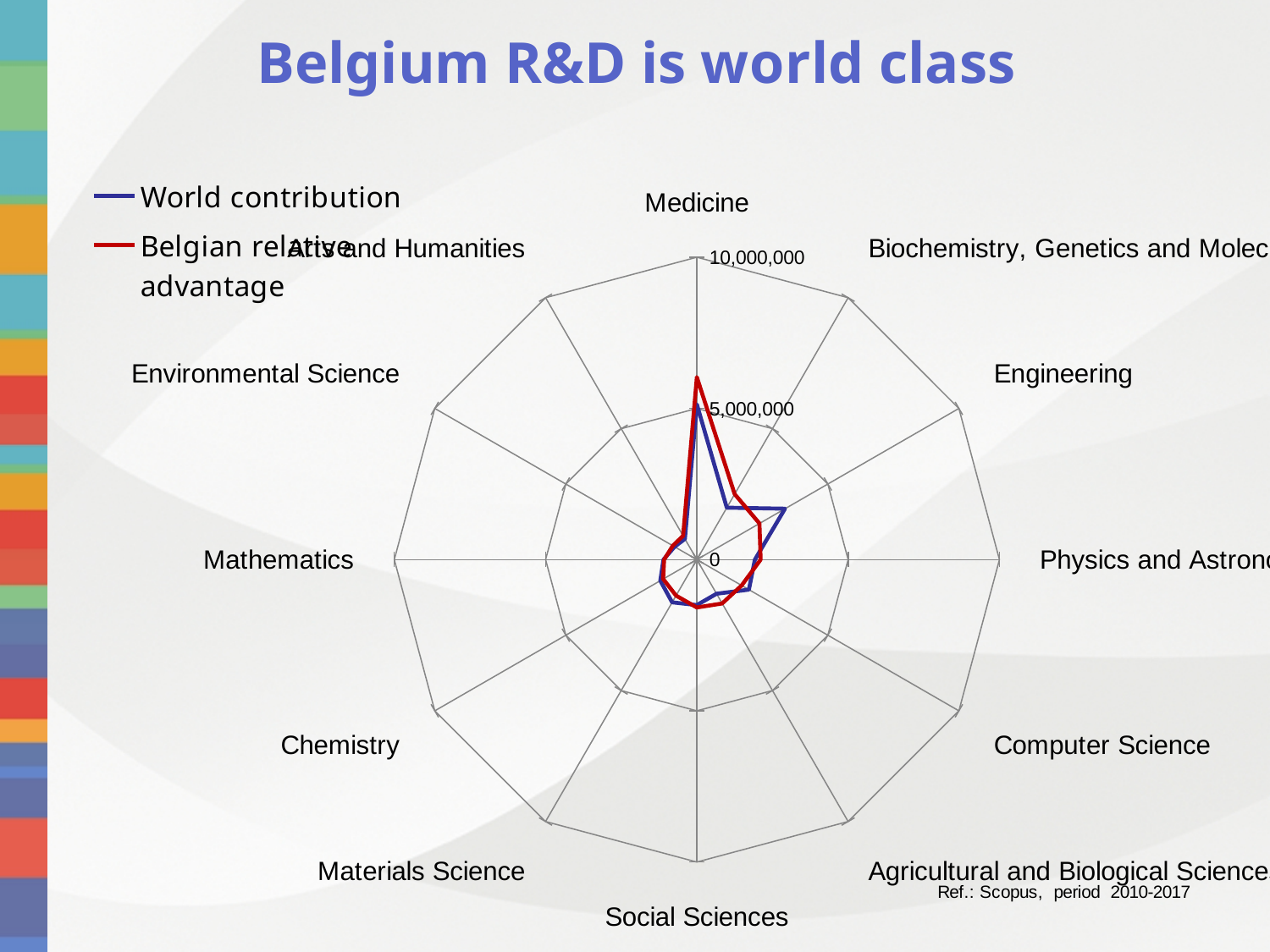
Which category has the highest value for the World contribution series? Medicine For the Belgian relative advantage series, which is larger: Medicine or Engineering? Medicine Which category has the highest value for the Belgian relative advantage series? Medicine Which colour represents the Belgian relative advantage series? Red Is the Belgian relative advantage value for Mathematics greater or less than 5,000,000? less For the World contribution series, which is larger: Medicine or Chemistry? Medicine What is the highest value shown on the chart's axis scale? 10,000,000 How many categories (axes) does the radar chart have? 12 Is the Belgian relative advantage value for Medicine greater or less than 5,000,000? greater Is the World contribution value for Engineering greater or less than 5,000,000? less How many series does the legend list? 2 What kind of chart is shown on the slide? Radar chart